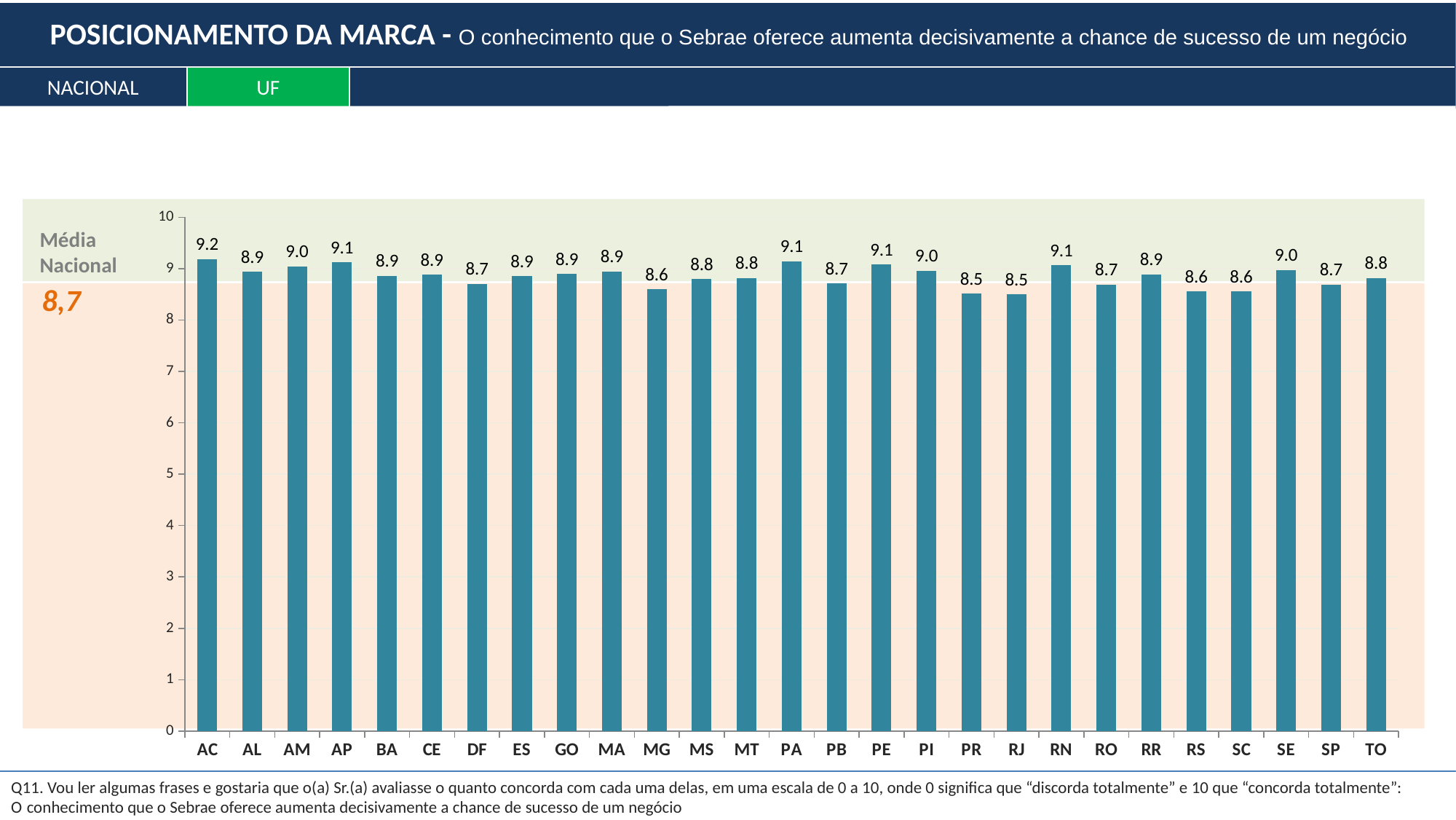
What is the value for SP? 8.7 What is the difference between the values for AC and RJ? 0.7 What is the difference between the values for SE and SC? 0.4 Is the value for PR greater or less than 8? greater What is the value for AC? 9.2 Which state (UF) has the highest value? AC What is the Média Nacional (national average) shown on the slide? 8,7 Which is larger, the value for PA or the value for PB? PA What is the value for RN? 9.1 What is the value for MG? 8.6 How many states (UFs) are shown on the x axis? 27 What kind of chart is shown on the slide? bar chart